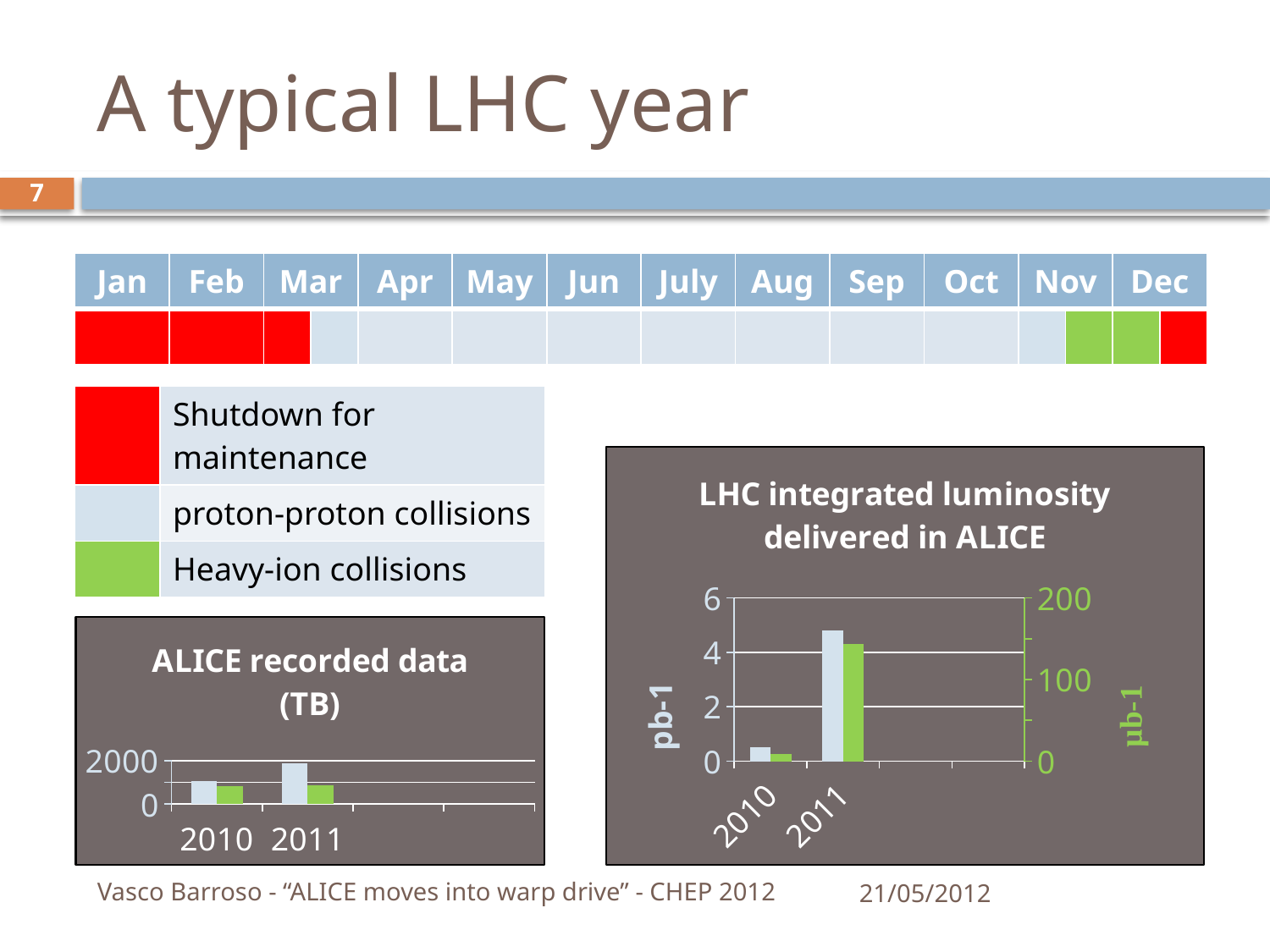
What is the label of the left vertical axis in the 'LHC integrated luminosity delivered in ALICE' chart? pb-1 In the 'LHC integrated luminosity delivered in ALICE' chart, how many years are shown on the x axis? 2 What is the label of the right vertical axis in the 'LHC integrated luminosity delivered in ALICE' chart? μb-1 In the 'LHC integrated luminosity delivered in ALICE' chart, which year has the taller light blue bar, 2010 or 2011? 2011 In the 'ALICE recorded data (TB)' chart, is the light blue bar for 2010 greater or less than 2000? less What kind of chart is the 'ALICE recorded data (TB)' chart? bar chart In the 'LHC integrated luminosity delivered in ALICE' chart, is the light blue bar for 2010 greater or less than 2 on the pb-1 axis? less In the 'ALICE recorded data (TB)' chart, which year has the taller light blue bar, 2010 or 2011? 2011 In the 'LHC integrated luminosity delivered in ALICE' chart, is the light blue bar for 2011 greater or less than 4 on the pb-1 axis? greater In the 'LHC integrated luminosity delivered in ALICE' chart, do the bars rise or fall from 2010 to 2011? rise In the 'ALICE recorded data (TB)' chart, how many years are shown on the x axis? 2 What kind of chart is the 'LHC integrated luminosity delivered in ALICE' chart? bar chart